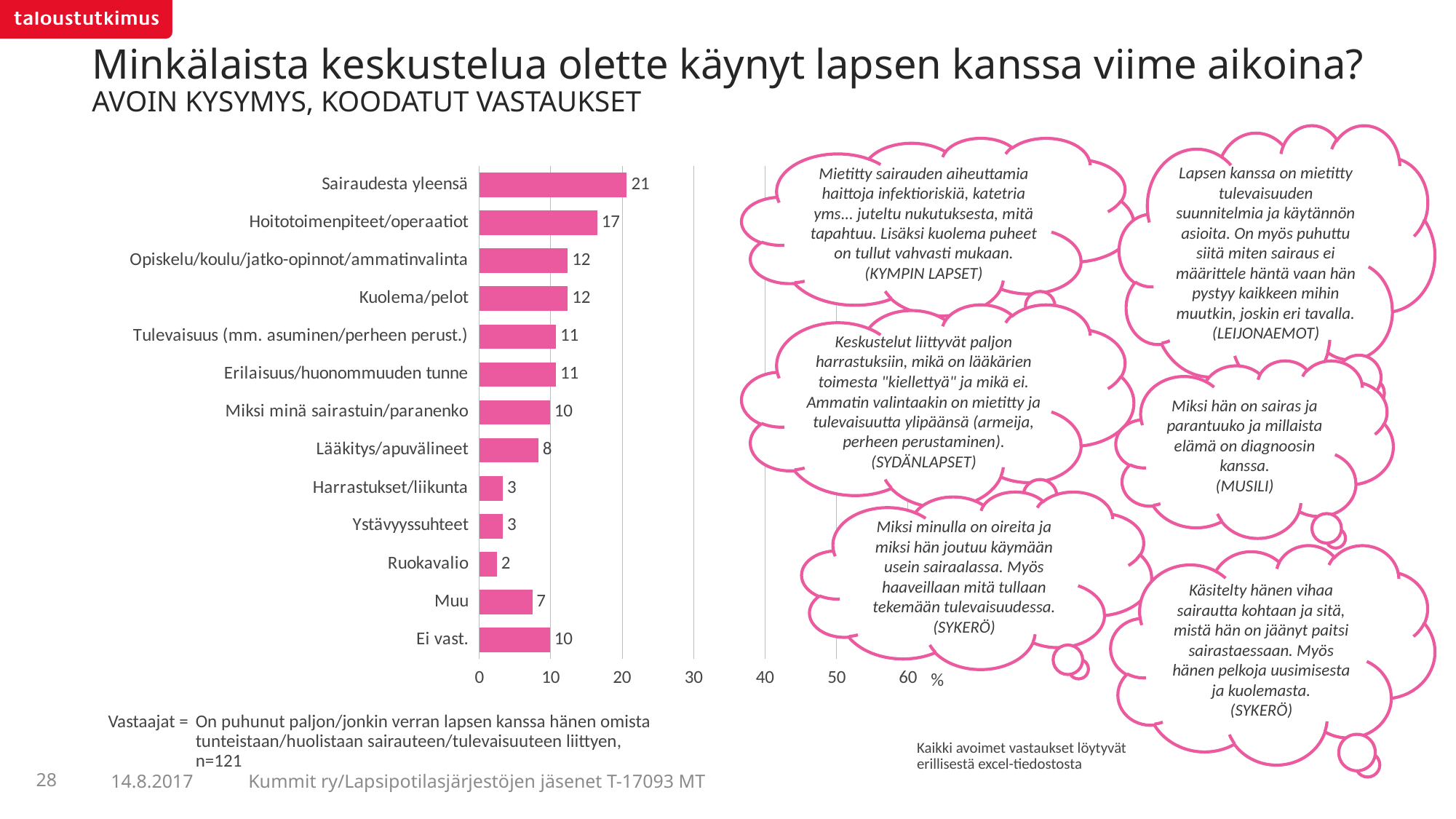
Which category has the lowest value? Ruokavalio How many categories are shown in the chart? 13 What is the value for Sairaudesta yleensä? 21 Which category has the highest value? Sairaudesta yleensä What is the value for Hoitotoimenpiteet/operaatiot? 17 What is the value for Ruokavalio? 2 What is the value for Lääkitys/apuvälineet? 8 What kind of chart is shown on the slide? bar chart Which is larger, Kuolema/pelot or Miksi minä sairastuin/paranenko? Kuolema/pelot Is the value for Sairaudesta yleensä greater or less than 20? greater What is the difference between Sairaudesta yleensä and Hoitotoimenpiteet/operaatiot? 4 What is the value for Ei vast.? 10